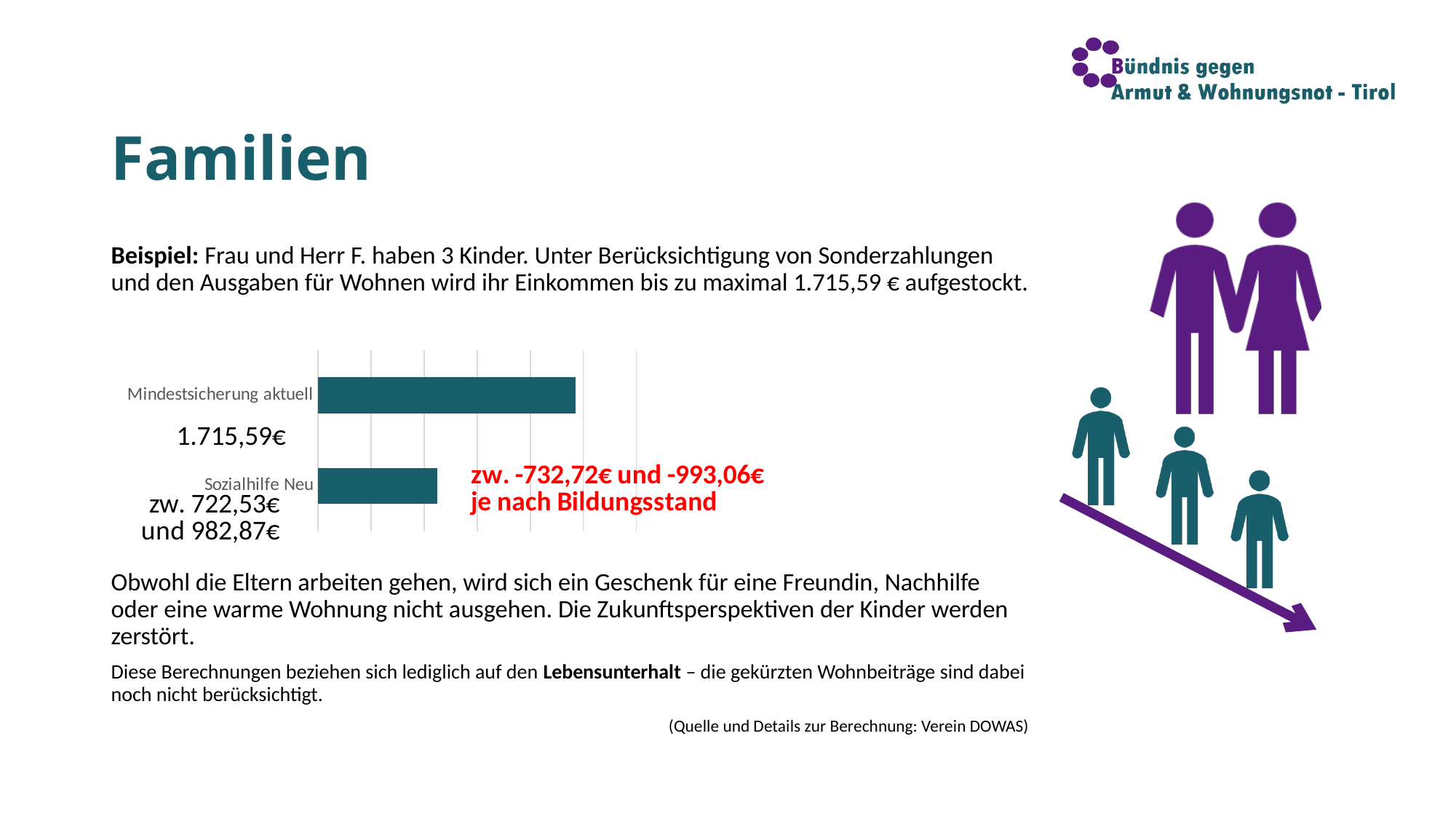
Which category has the longer bar? Mindestsicherung aktuell How many categories does the bar chart show? 2 According to the red annotation, by how much is "Sozialhilfe Neu" lower than "Mindestsicherung aktuell"? zw. -732,72€ und -993,06€ je nach Bildungsstand Is the bar for "Mindestsicherung aktuell" longer or shorter than the bar for "Sozialhilfe Neu"? longer What colour are the bars in the chart? teal What kind of chart is shown on the slide? bar chart What value is shown for "Mindestsicherung aktuell"? 1.715,59€ What value range is shown for "Sozialhilfe Neu"? zw. 722,53€ und 982,87€ Which category has the shorter bar? Sozialhilfe Neu What is the label of the top bar in the chart? Mindestsicherung aktuell